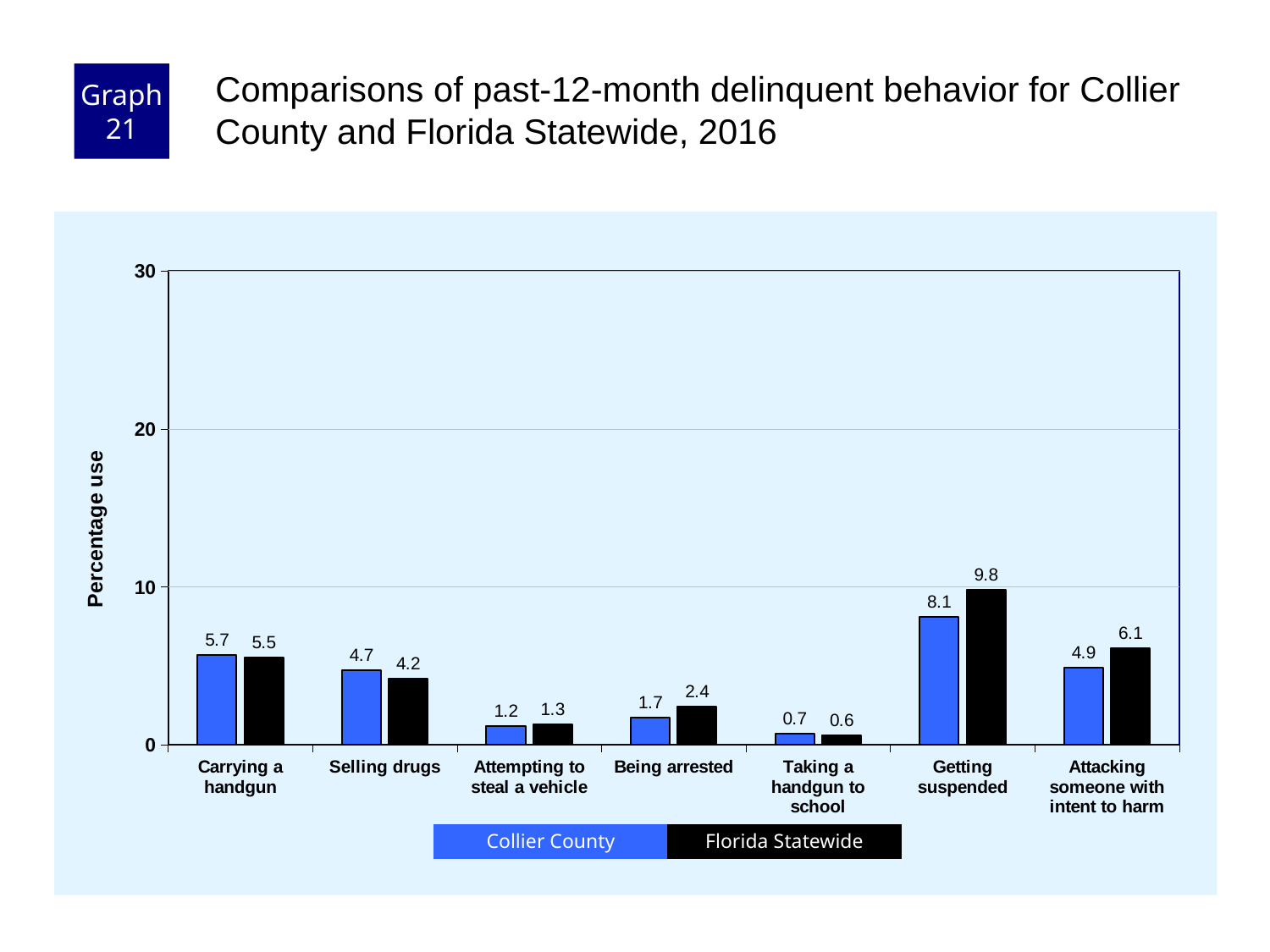
What is the Collier County value for Getting suspended? 8.1 Which category has the lowest Collier County value? Taking a handgun to school For Selling drugs, which is larger: the Collier County value or the Florida Statewide value? Collier County What kind of chart is shown on the slide? Bar chart How many series does the legend list? 2 What is the difference between the Florida Statewide and Collier County values for Getting suspended? 1.7 How many categories are shown on the x axis? 7 Which category has the highest Florida Statewide value? Getting suspended What is the difference between the Florida Statewide and Collier County values for Attacking someone with intent to harm? 1.2 What is the Florida Statewide value for Being arrested? 2.4 Is the Florida Statewide value for Getting suspended greater or less than 10? less What is the Collier County value for Taking a handgun to school? 0.7